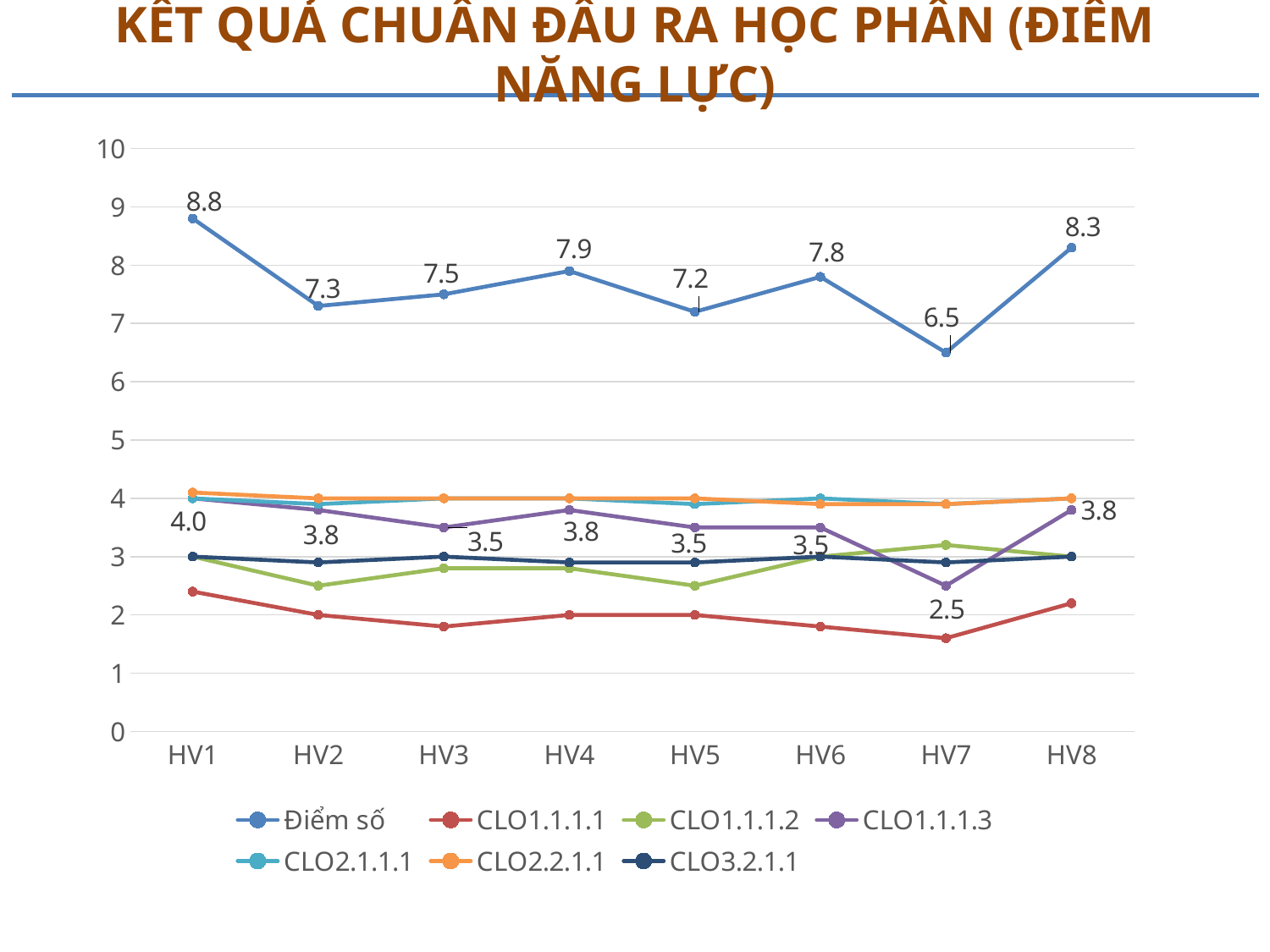
What is the difference between the Điểm số values for HV1 and HV7? 2.3 How many categories are shown on the x axis? 8 Which category has the lowest Điểm số value? HV7 Which is larger, the Điểm số value for HV4 or for HV5? HV4 How many series does the legend list? 7 What is the Điểm số value for HV1? 8.8 What kind of chart is shown on the slide? line chart What is the CLO1.1.1.3 value for HV7? 2.5 Is the CLO1.1.1.1 value for HV3 greater or less than 2? less Which category has the highest Điểm số value? HV1 What is the CLO1.1.1.3 value for HV1? 4.0 What is the Điểm số value for HV7? 6.5